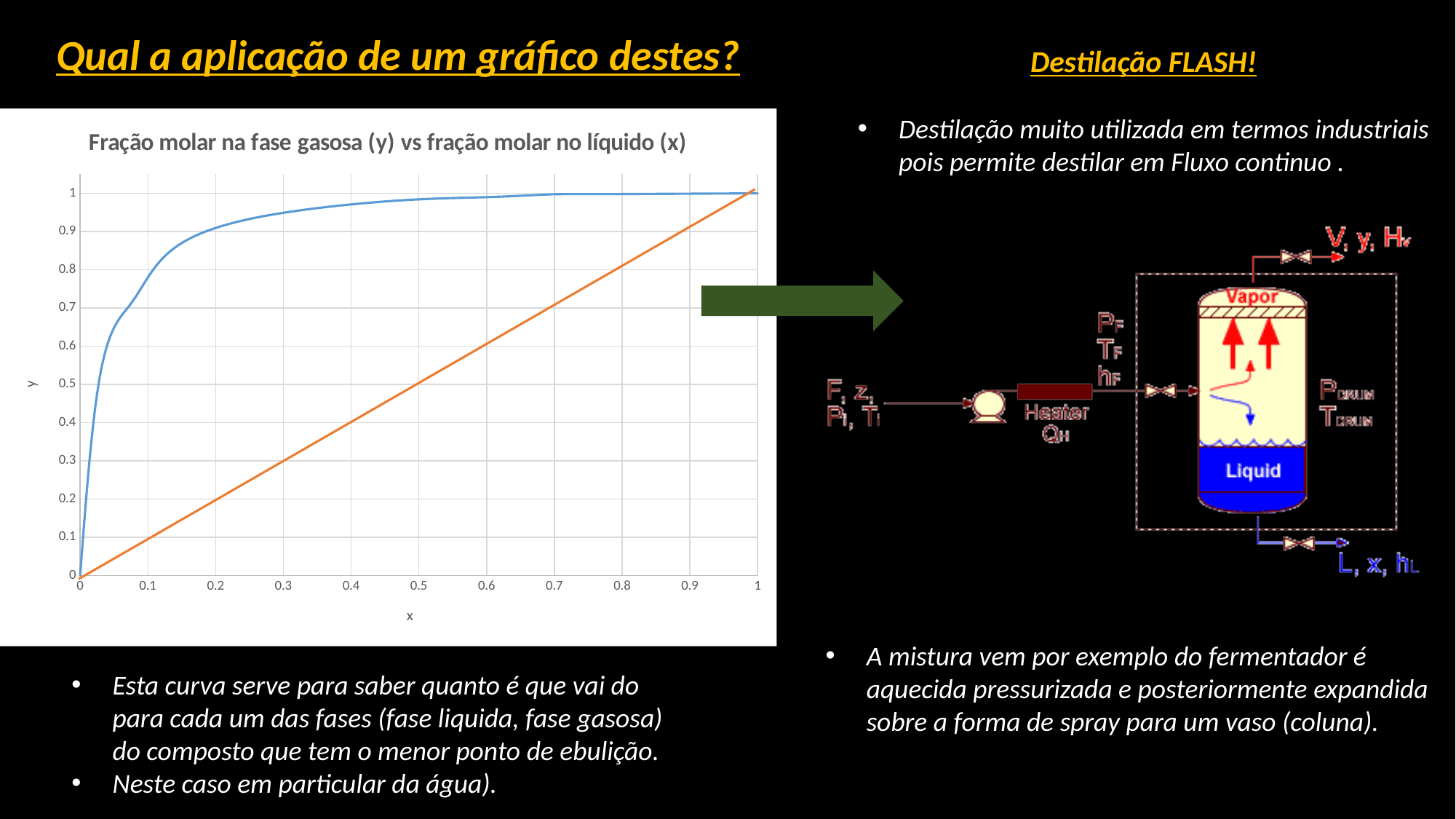
Is the value of the blue curve at x = 0.5 greater or less than 0.9? greater Is the value of the blue curve at x = 0.8 greater or less than 0.9? greater What is the y value of the orange line at x = 1? 1 What is the label of the horizontal axis of the chart? x What is the title of the chart? Fração molar na fase gasosa (y) vs fração molar no líquido (x) How many lines are plotted on the chart? 2 What is the y value of the blue curve at x = 0? 0 Does the blue curve rise or fall as x increases from 0 to 1? rise Is the value of the blue curve at x = 0.1 greater or less than 0.6? greater At x = 0.5, which line has the higher y value, the blue curve or the orange line? the blue curve What kind of chart is shown on the slide? line chart